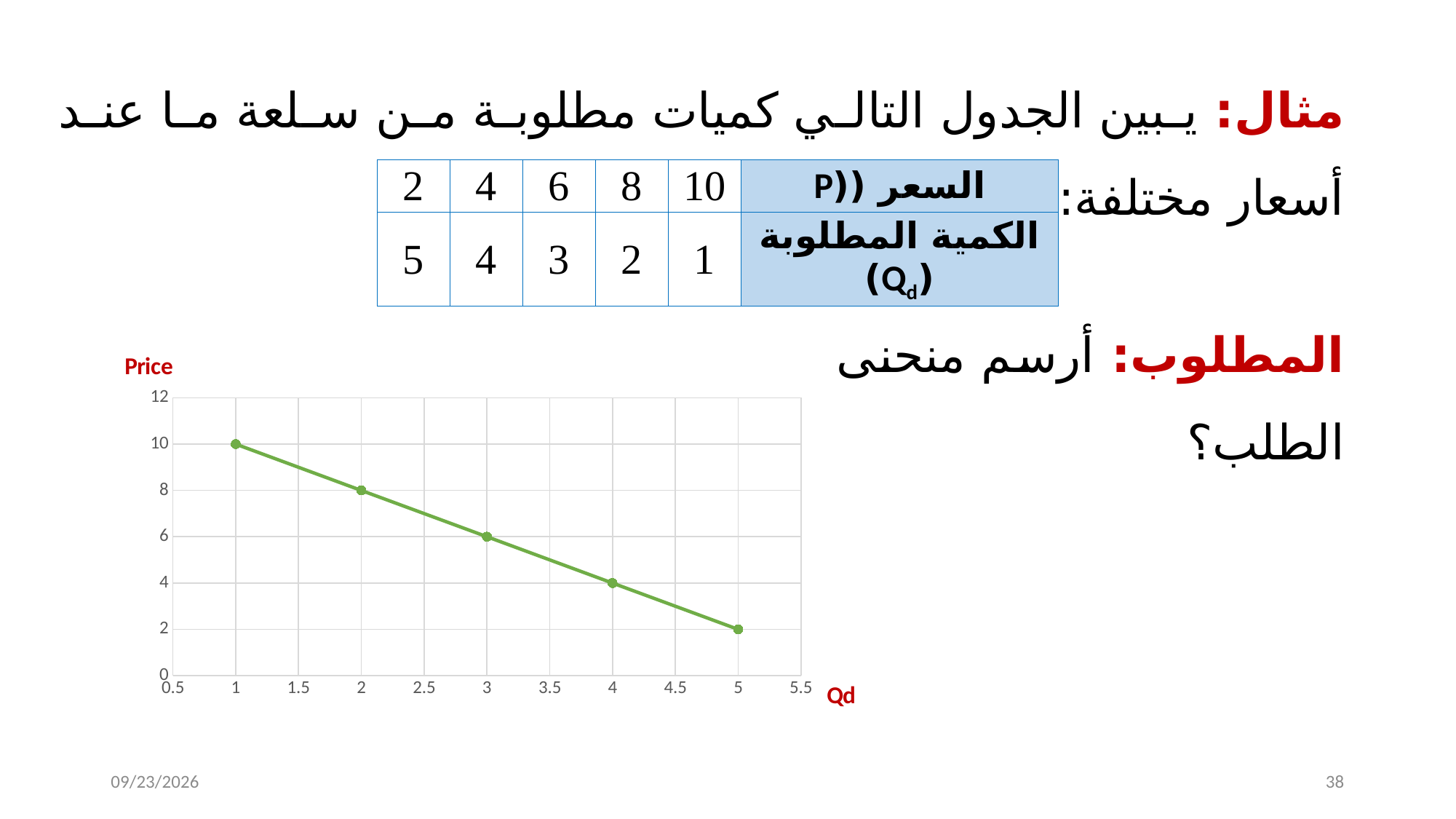
What is the price when the quantity demanded (Qd) is 3? 6 What is the price when the quantity demanded (Qd) is 5? 2 What is the label of the horizontal axis of the chart? Qd What kind of chart is shown on the slide? line chart Which is larger: the price at Qd = 2 or the price at Qd = 4? Qd = 2 At which quantity demanded (Qd) is the price lowest? 5 What is the difference between the price at Qd = 1 and the price at Qd = 4? 6 At which quantity demanded (Qd) is the price highest? 1 What is the price when the quantity demanded (Qd) is 1? 10 What is the label of the vertical axis of the chart? Price Does the price rise or fall as the quantity demanded (Qd) increases along the x axis? fall How many data points are plotted on the chart? 5